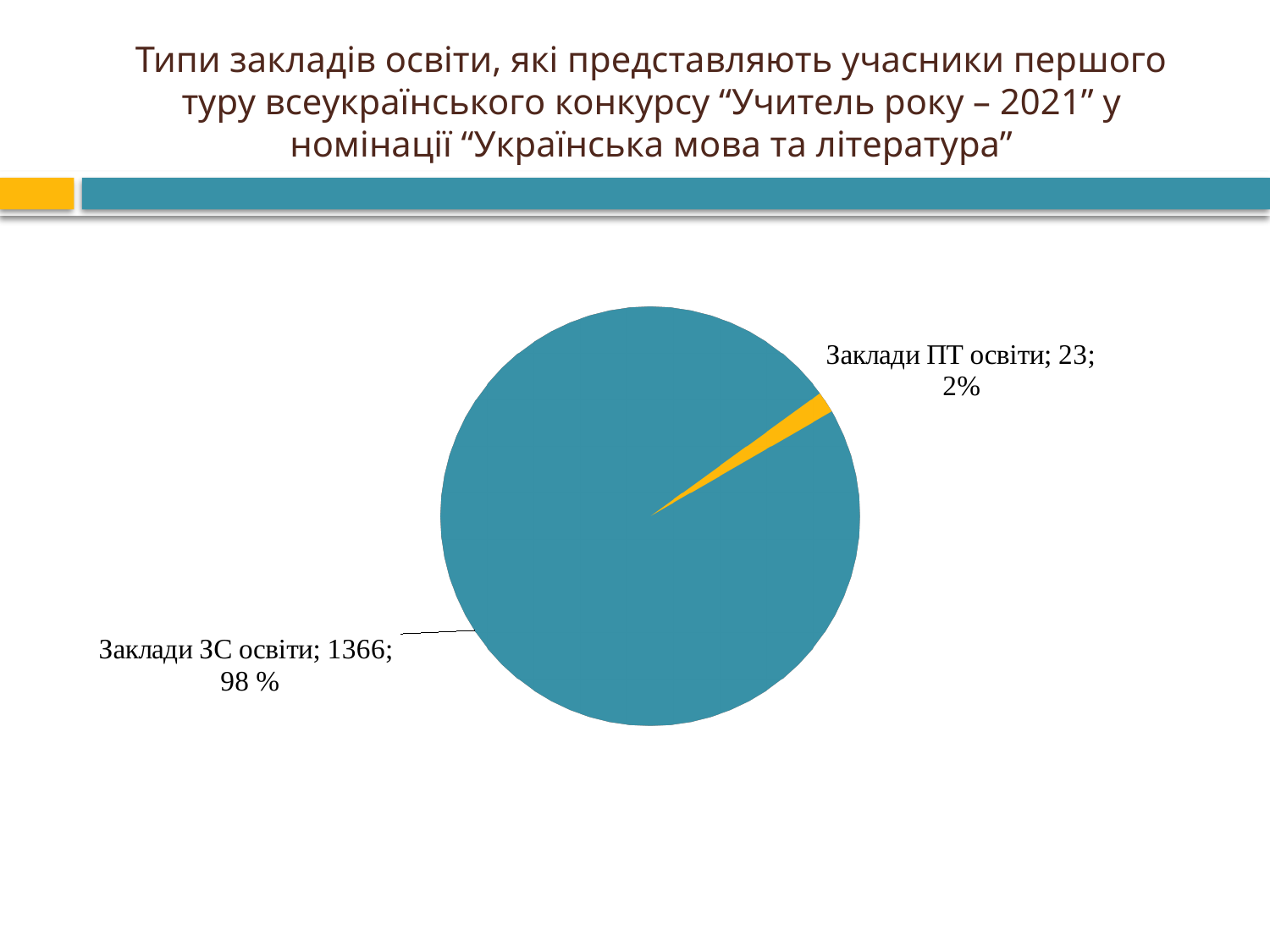
What colour is the slice for Заклади ПТ освіти? yellow Which is larger, the value for Заклади ЗС освіти or Заклади ПТ освіти? Заклади ЗС освіти What is the value for Заклади ЗС освіти? 1366 What is the difference between the values for Заклади ЗС освіти and Заклади ПТ освіти? 1343 What is the total of the two slices in the pie chart? 1389 What share of the pie does Заклади ЗС освіти represent? 98 % Which category has the smallest slice? Заклади ПТ освіти How many slices does the pie chart have? 2 What share of the pie does Заклади ПТ освіти represent? 2% What is the value for Заклади ПТ освіти? 23 What kind of chart is shown on the slide? pie chart Which category has the largest slice? Заклади ЗС освіти